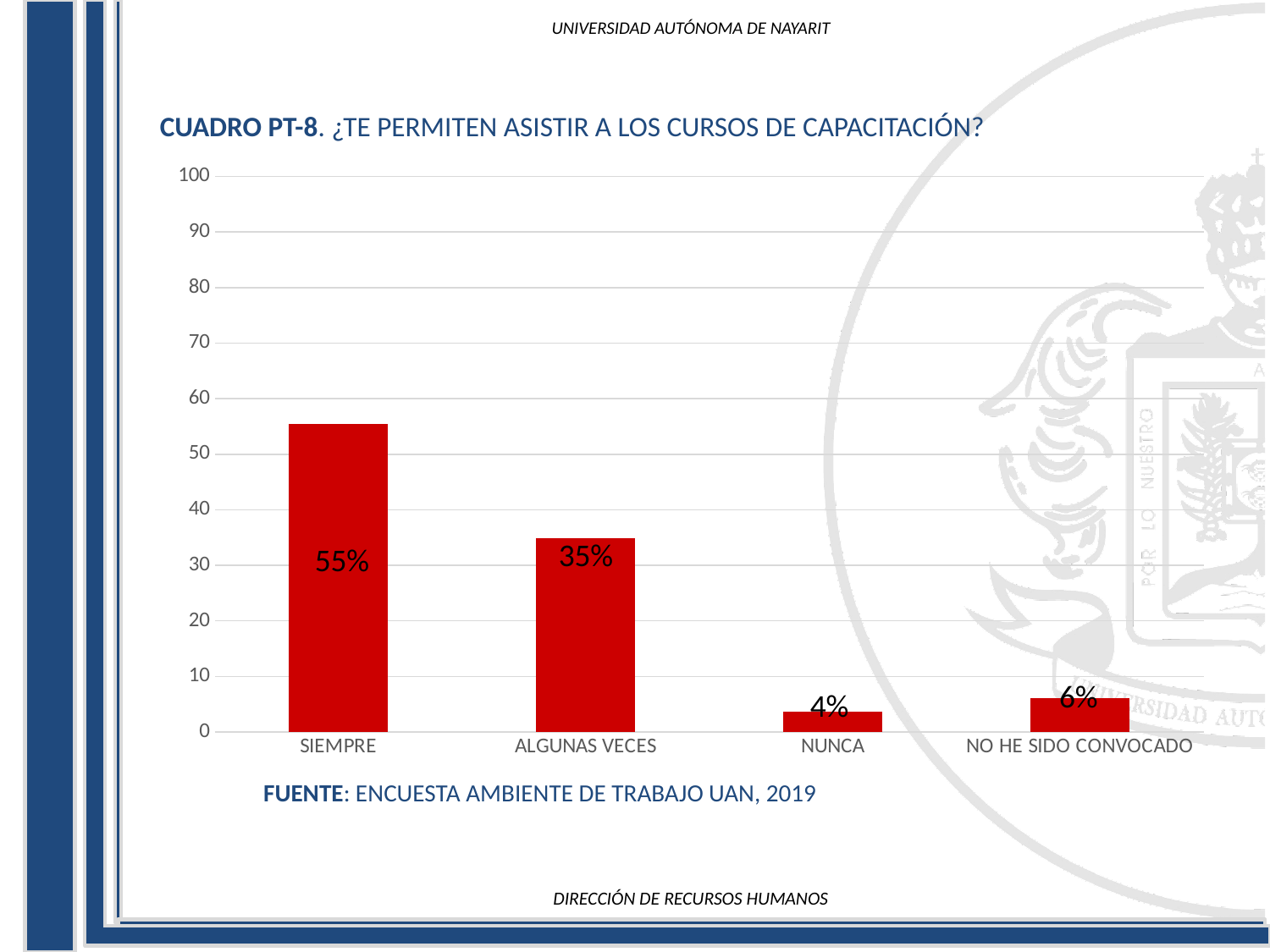
What kind of chart is shown on the slide? bar chart Which category has the lowest value? NUNCA Is the value for SIEMPRE greater or less than 50? greater What is the difference between the values for SIEMPRE and ALGUNAS VECES? 20% Which category has the highest value? SIEMPRE What is the value for ALGUNAS VECES? 35% Which is larger, the value for NUNCA or the value for NO HE SIDO CONVOCADO? NO HE SIDO CONVOCADO What is the title of the chart? CUADRO PT-8. ¿TE PERMITEN ASISTIR A LOS CURSOS DE CAPACITACIÓN? What is the value for NO HE SIDO CONVOCADO? 6% What is the value for NUNCA? 4% What is the value for SIEMPRE? 55% How many categories are shown on the x axis? 4